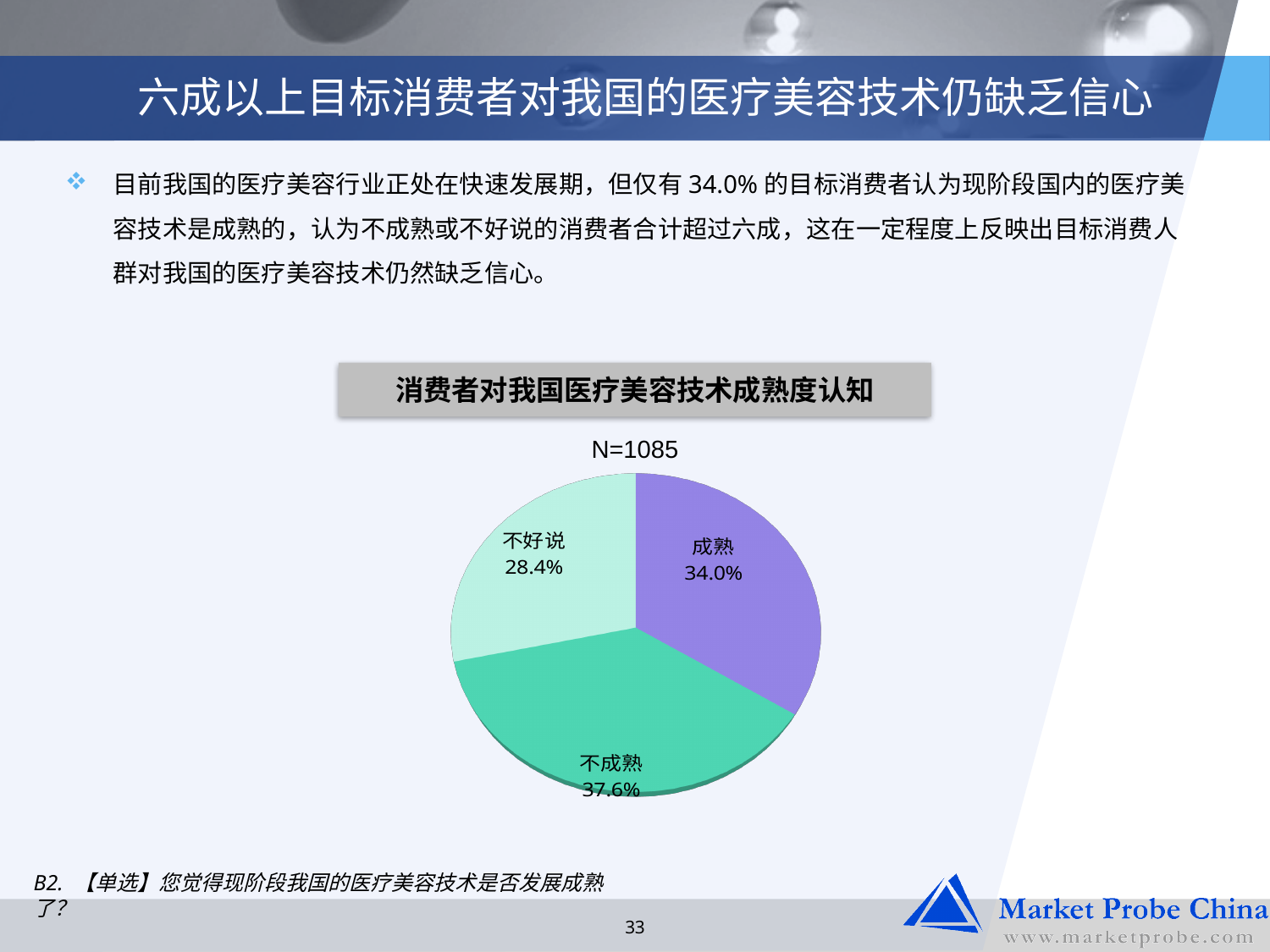
What is the difference in percentage points between 不成熟 and 成熟? 3.6 Which category has the largest share of the pie? 不成熟 What percentage of respondents answered 不成熟? 37.6% What type of chart is shown on the slide? pie chart What is the sample size (N) shown above the pie chart? N=1085 What is the combined share of 不成熟 and 不好说? 66.0% Which is larger, the share for 成熟 or the share for 不好说? 成熟 How many slices does the pie chart have? 3 What percentage of respondents answered 不好说? 28.4% What is the title of the chart? 消费者对我国医疗美容技术成熟度认知 Which category has the smallest share of the pie? 不好说 What percentage of respondents answered 成熟 in the pie chart? 34.0%